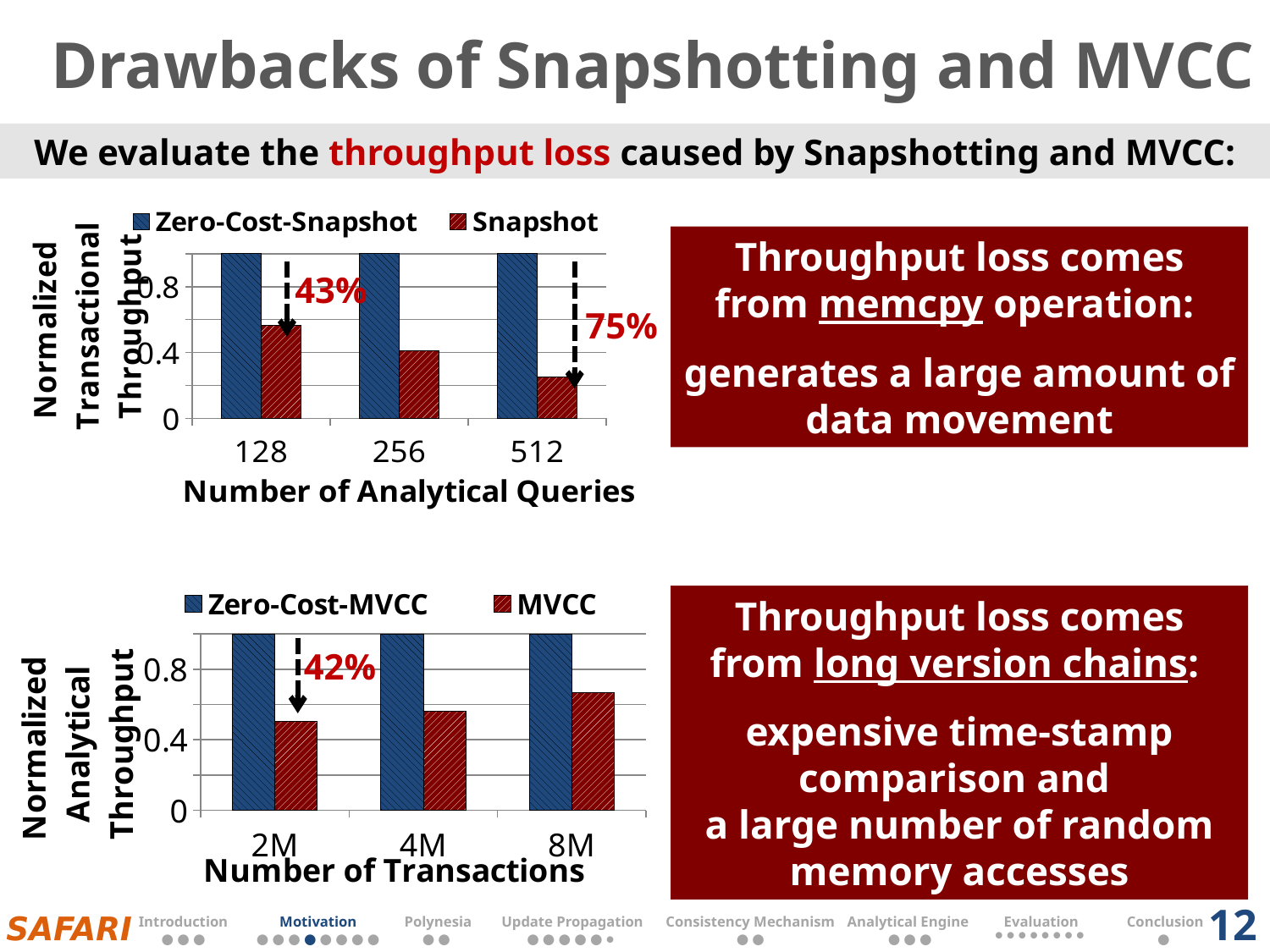
In the bottom chart (Number of Transactions), how many series does the legend list? 2 In the top chart (Number of Analytical Queries), how many categories are shown on the x axis? 3 In the top chart (Number of Analytical Queries), what kind of chart is shown? bar chart In the top chart (Number of Analytical Queries), is the Snapshot value at 512 queries greater or less than 0.4? less In the top chart (Number of Analytical Queries), how many series does the legend list? 2 In the top chart (Number of Analytical Queries), does the Snapshot throughput rise or fall as the number of analytical queries increases? fall In the bottom chart (Number of Transactions), at which number of transactions is the MVCC throughput lowest? 2M In the bottom chart (Number of Transactions), does the MVCC throughput rise or fall as the number of transactions increases? rise In the top chart (Number of Analytical Queries), at which number of queries is the Snapshot throughput lowest? 512 In the bottom chart (Number of Transactions), is the MVCC value at 8M transactions greater or less than 0.8? less In the bottom chart (Number of Transactions), what throughput loss percentage is annotated at 2M transactions? 42% In the top chart (Number of Analytical Queries), what throughput loss percentage is annotated at 512 queries? 75%